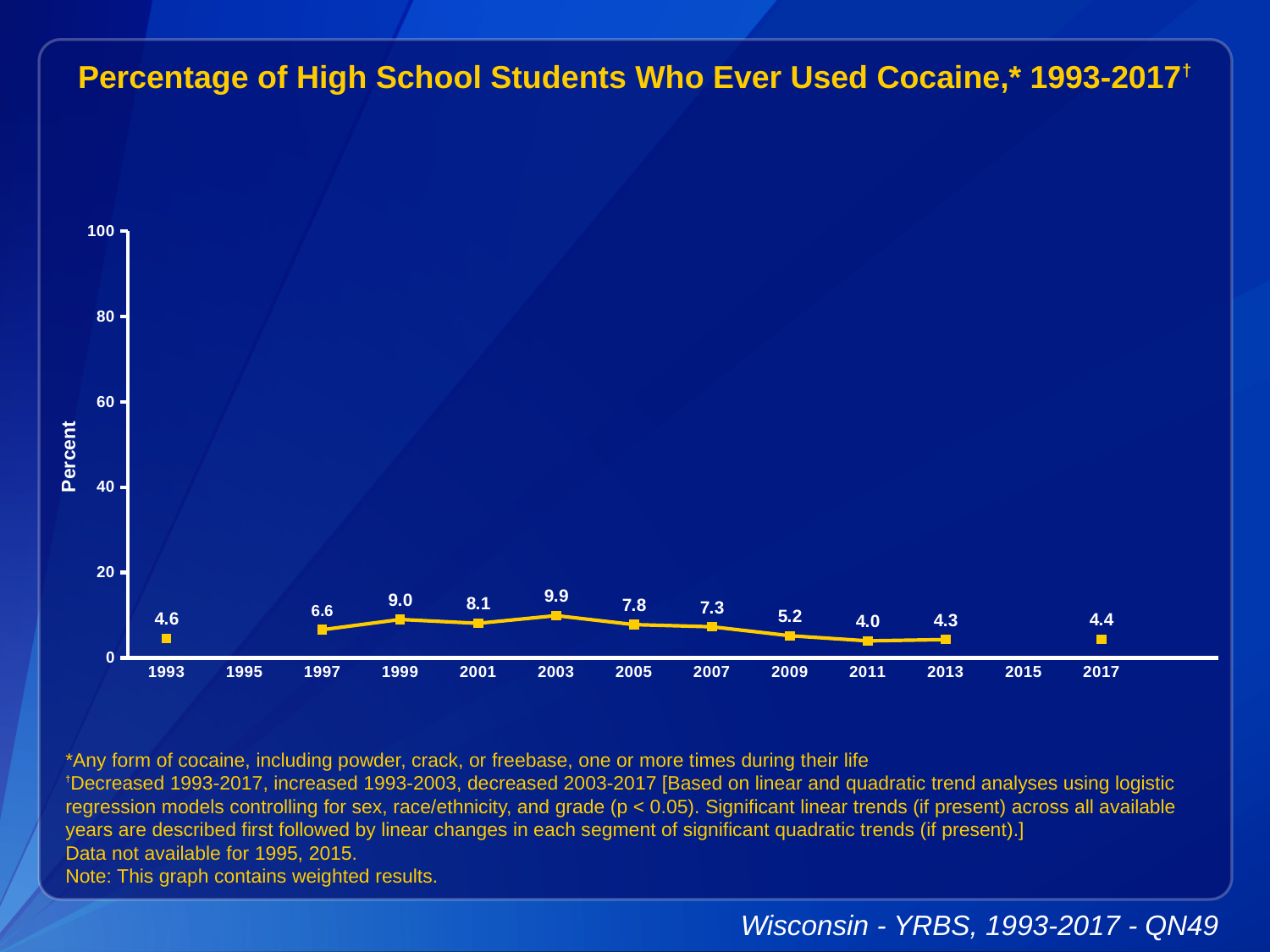
Did the values rise or fall from 2003 to 2011? fall What is the difference between the 2003 value and the 2017 value? 5.5 What kind of chart is shown on the slide? line chart How many years have data points plotted on the chart? 11 What is the label on the vertical axis? Percent Which year has the lowest percentage of students who ever used cocaine? 2011 What is the value plotted for 2017? 4.4 What percentage of high school students had ever used cocaine in 2003? 9.9 Which year has a larger value, 1999 or 2007? 1999 Is the value for 2003 greater or less than 20? less What is the value plotted for 1993? 4.6 Which year has the highest percentage of students who ever used cocaine? 2003